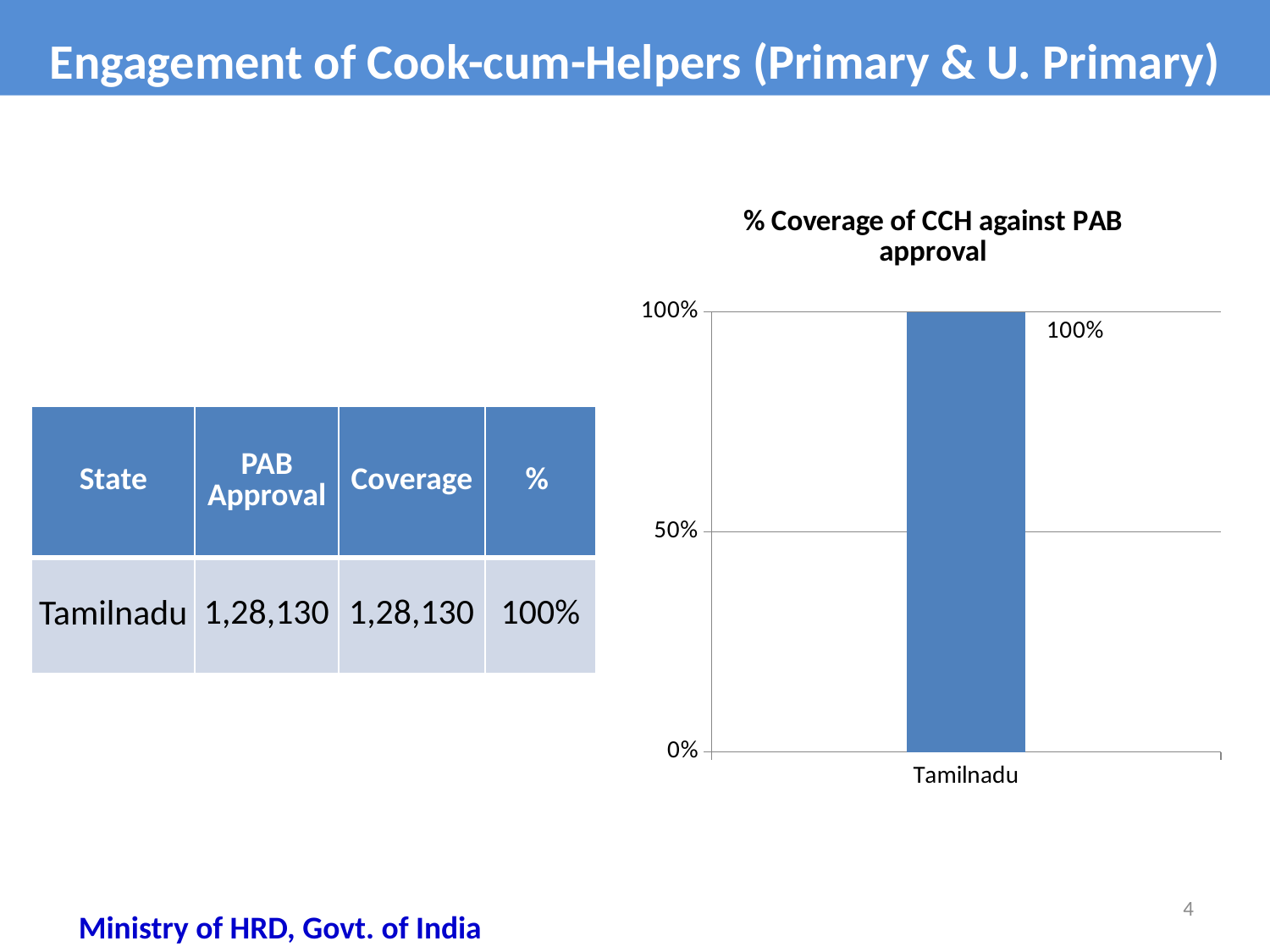
Is the value for Tamilnadu greater or less than 50%? greater What is the highest value shown on the y axis of the chart? 100% What is the value for Tamilnadu in the chart? 100% How many categories are plotted in the chart? 1 Which category is shown on the x axis of the chart? Tamilnadu What kind of chart is shown on the slide? bar chart What is the title of the chart? % Coverage of CCH against PAB approval